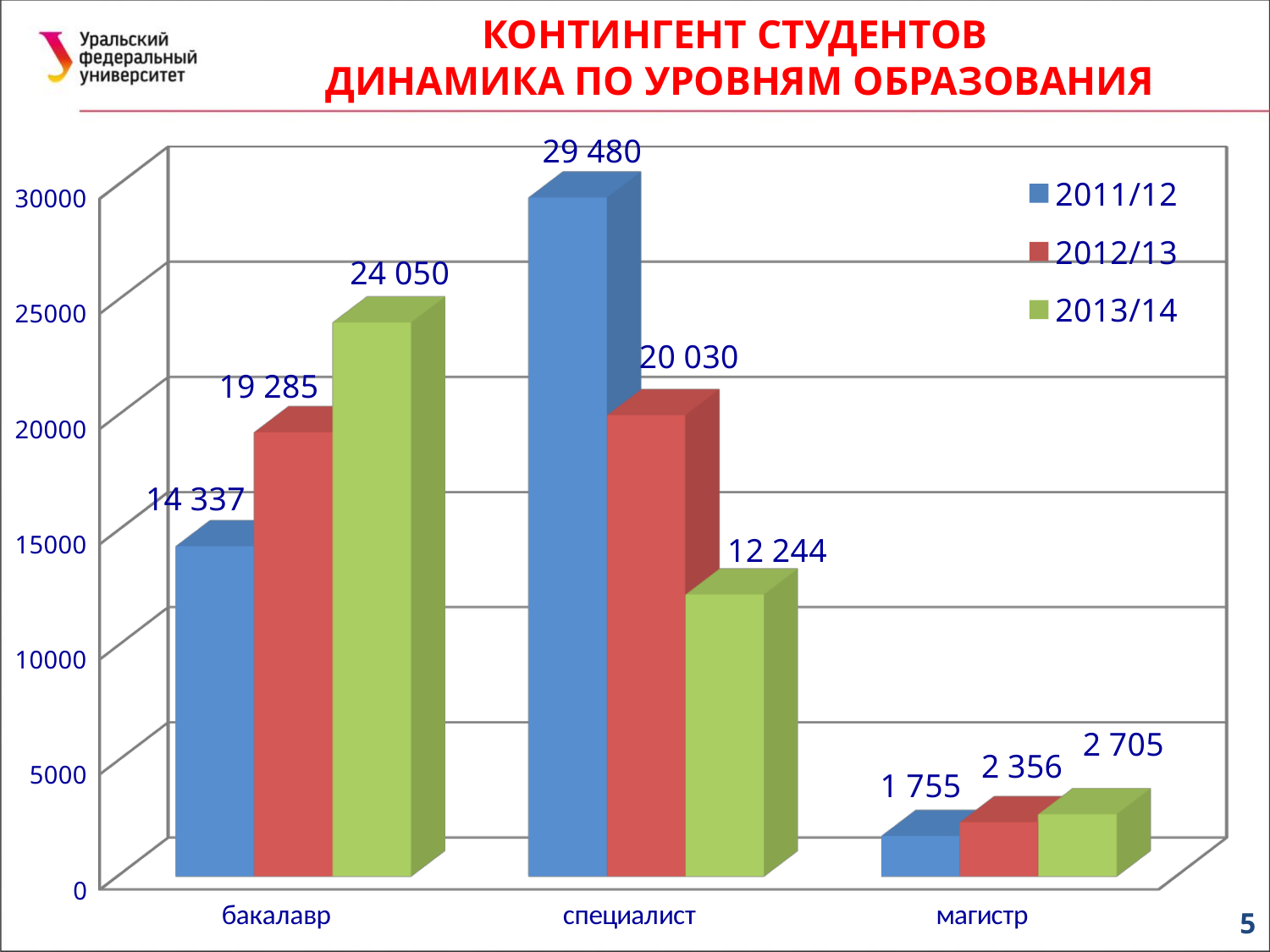
What is the value for магистр in 2012/13? 2 356 What kind of chart is shown on the slide? bar chart How many series does the legend list? 3 Do the values for магистр rise or fall from 2011/12 to 2013/14? rise How many categories are shown on the x axis? 3 Which category has the highest value in 2011/12? специалист What is the value for бакалавр in 2013/14? 24 050 Which category has the lowest value in 2013/14? магистр What is the difference between the 2011/12 and 2013/14 values for специалист? 17 236 What is the value for специалист in 2011/12? 29 480 Which is larger: бакалавр in 2012/13 or специалист in 2012/13? специалист in 2012/13 What is the difference between the 2013/14 and 2011/12 values for бакалавр? 9 713